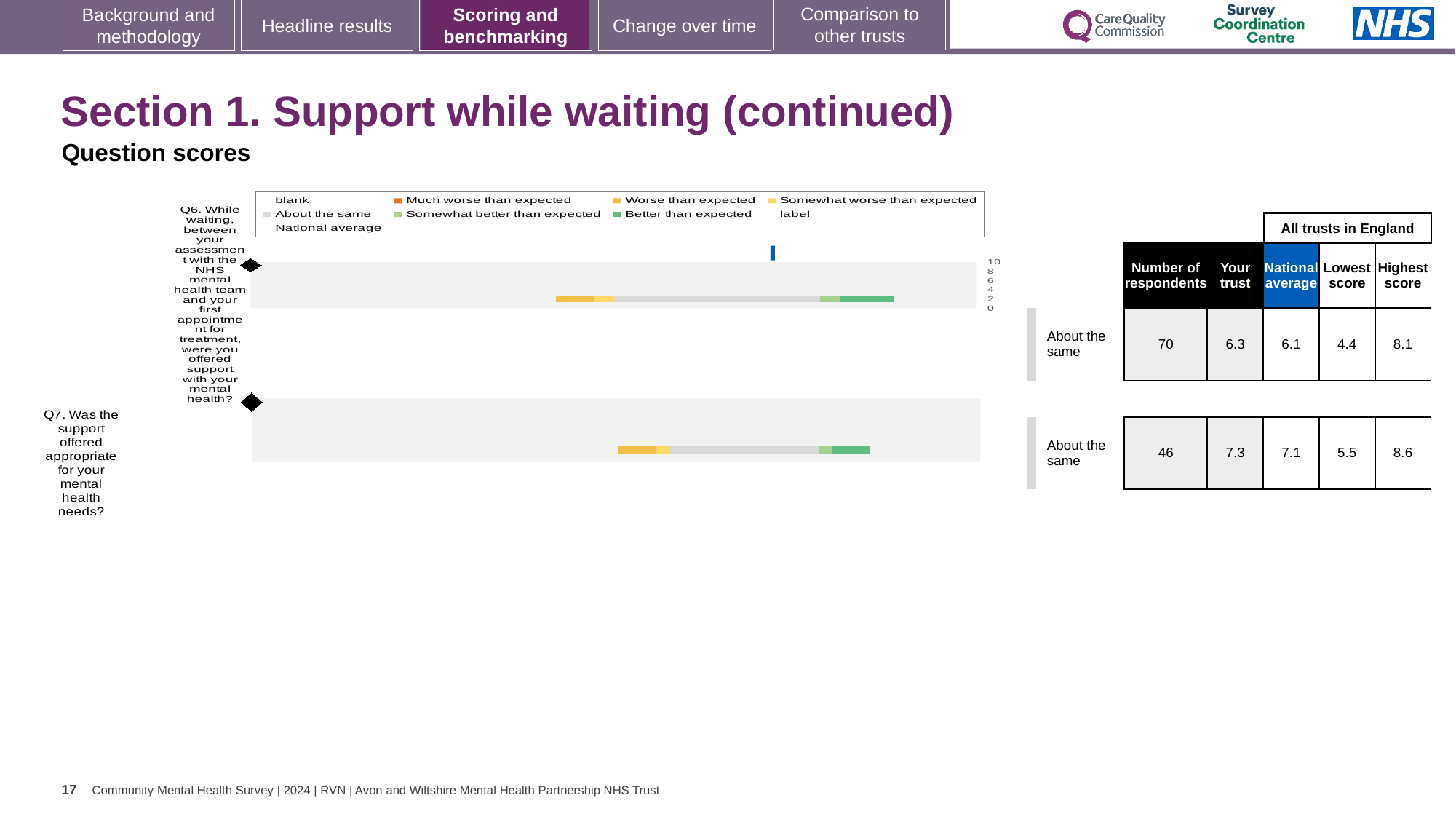
What is the difference between the highest and lowest scores for Q6? 3.7 What is the lowest score among all trusts in England for Q7? 5.5 What kind of chart is used to show the question scores on this slide? bar chart How many respondents answered Q7? 46 What benchmark category is shown for both Q6 and Q7? About the same Which question has the higher 'Your trust' score, Q6 or Q7? Q7 How many questions are plotted in the question scores chart? 2 What is the highest score among all trusts in England for Q6? 8.1 What is the 'Your trust' score for Q6 (support while waiting between assessment and first appointment)? 6.3 How many entries does the chart legend list? 9 What is the national average score for Q7 (was the support offered appropriate for your mental health needs)? 7.1 By how much does the trust's score for Q7 exceed the national average for Q7? 0.2